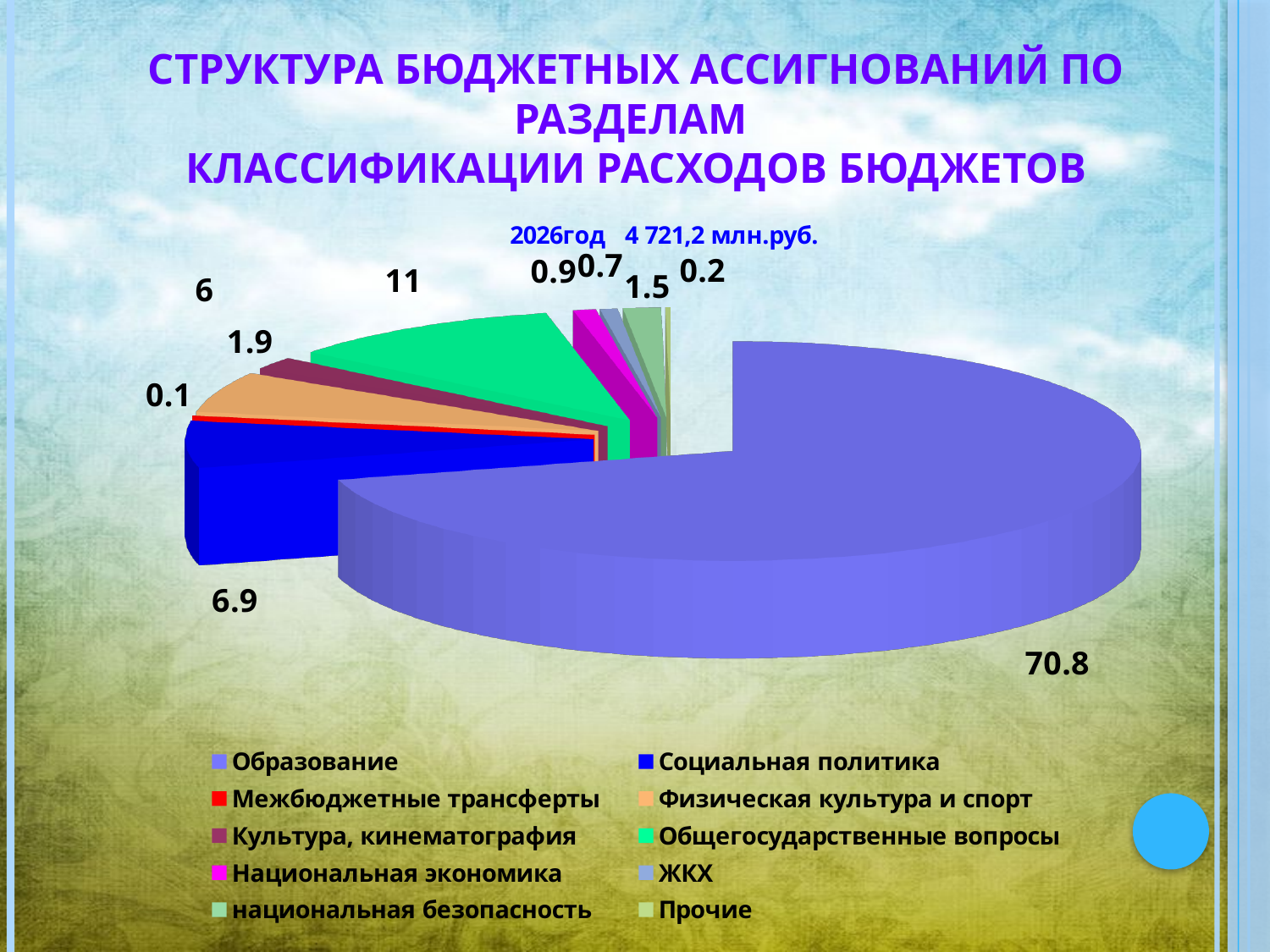
Which category has the largest slice of the pie? Образование What is the value shown for Общегосударственные вопросы? 11 What total amount in million rubles is stated in the chart title for 2026? 4 721,2 млн.руб. What is the value shown for Образование? 70.8 Which category has the smallest slice of the pie? Межбюджетные трансферты Which is larger, the value for Социальная политика or the value for Физическая культура и спорт? Социальная политика What is the value shown for Социальная политика? 6.9 What is the value shown for Культура, кинематография? 1.9 How many categories does the legend list? 10 What is the difference between the values for Образование and Общегосударственные вопросы? 59.8 What is the value shown for национальная безопасность? 1.5 What type of chart is shown on the slide? pie chart